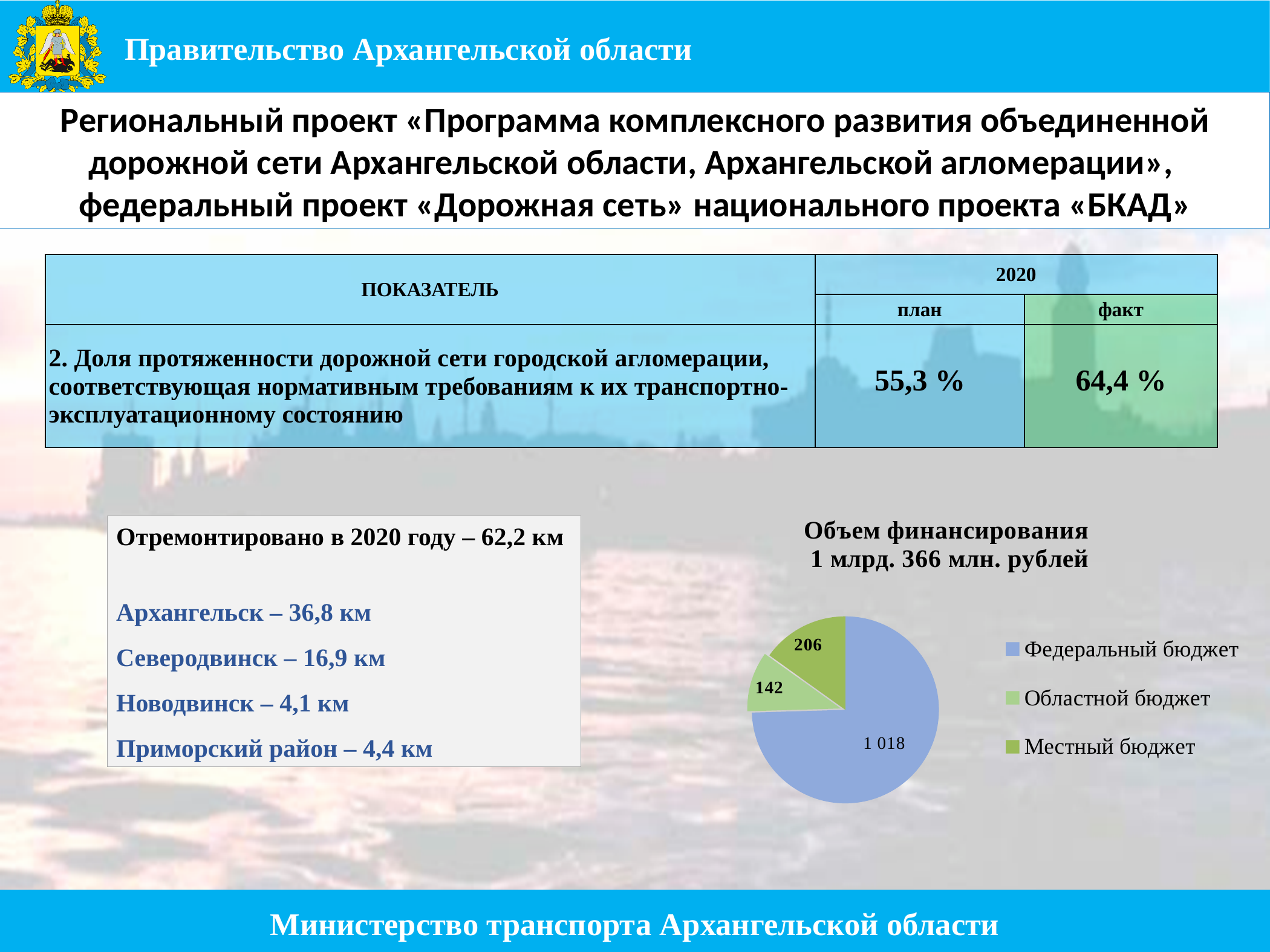
Which budget source has the smallest slice in the pie chart? Областной бюджет What is the total of all slices in the pie chart? 1 366 What is the value for Областной бюджет in the pie chart? 142 What is the difference between the values for Федеральный бюджет and Местный бюджет in the pie chart? 812 Which budget source has the largest slice in the pie chart? Федеральный бюджет What is the title of the pie chart? Объем финансирования 1 млрд. 366 млн. рублей What is the difference between the values for Местный бюджет and Областной бюджет in the pie chart? 64 What is the value for Местный бюджет in the pie chart? 206 What kind of chart is shown on the slide? pie chart Which is larger in the pie chart: Местный бюджет or Областной бюджет? Местный бюджет How many slices does the pie chart have? 3 What is the value for Федеральный бюджет in the pie chart? 1 018